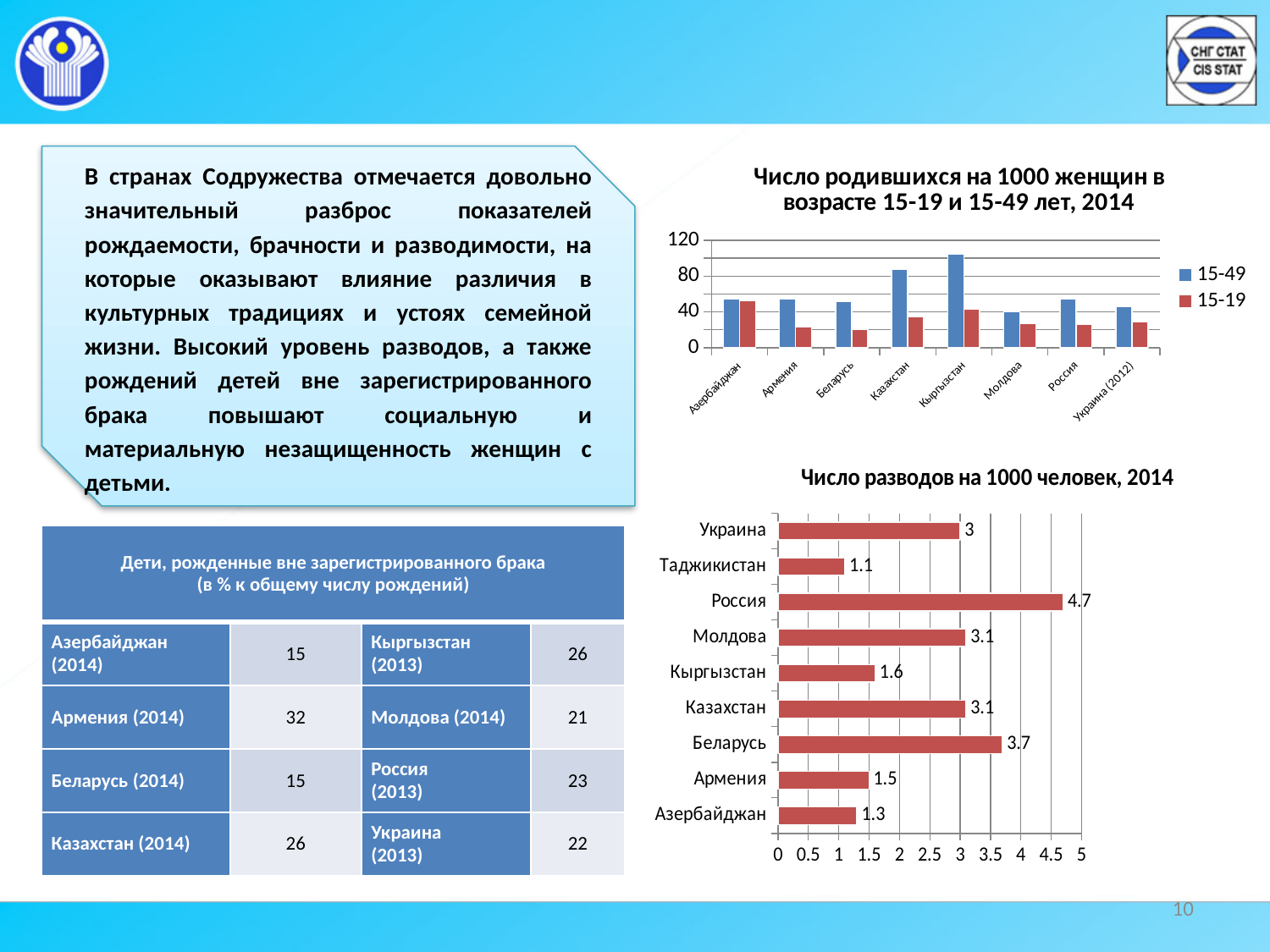
In the chart "Число родившихся на 1000 женщин в возрасте 15-19 и 15-49 лет, 2014", is the 15-19 value for Армения greater or less than 40? less In the chart "Число разводов на 1000 человек, 2014", what is the value for Кыргызстан? 1.6 In the chart "Число родившихся на 1000 женщин в возрасте 15-19 и 15-49 лет, 2014", which country has the highest value for the 15-49 series? Кыргызстан How many countries are shown in the chart "Число разводов на 1000 человек, 2014"? 9 In the chart "Число разводов на 1000 человек, 2014", what is the difference between the values for Россия and Украина? 1.7 In the chart "Число разводов на 1000 человек, 2014", what is the value for Россия? 4.7 How many series does the legend list in the chart "Число родившихся на 1000 женщин в возрасте 15-19 и 15-49 лет, 2014"? 2 In the chart "Число разводов на 1000 человек, 2014", which is larger, the value for Беларусь or for Армения? Беларусь In the chart "Число разводов на 1000 человек, 2014", which country has the highest value? Россия What type of chart is "Число разводов на 1000 человек, 2014"? bar chart In the chart "Число разводов на 1000 человек, 2014", which country has the lowest value? Таджикистан In the chart "Число родившихся на 1000 женщин в возрасте 15-19 и 15-49 лет, 2014", is the 15-49 value for Казахстан greater or less than 80? greater